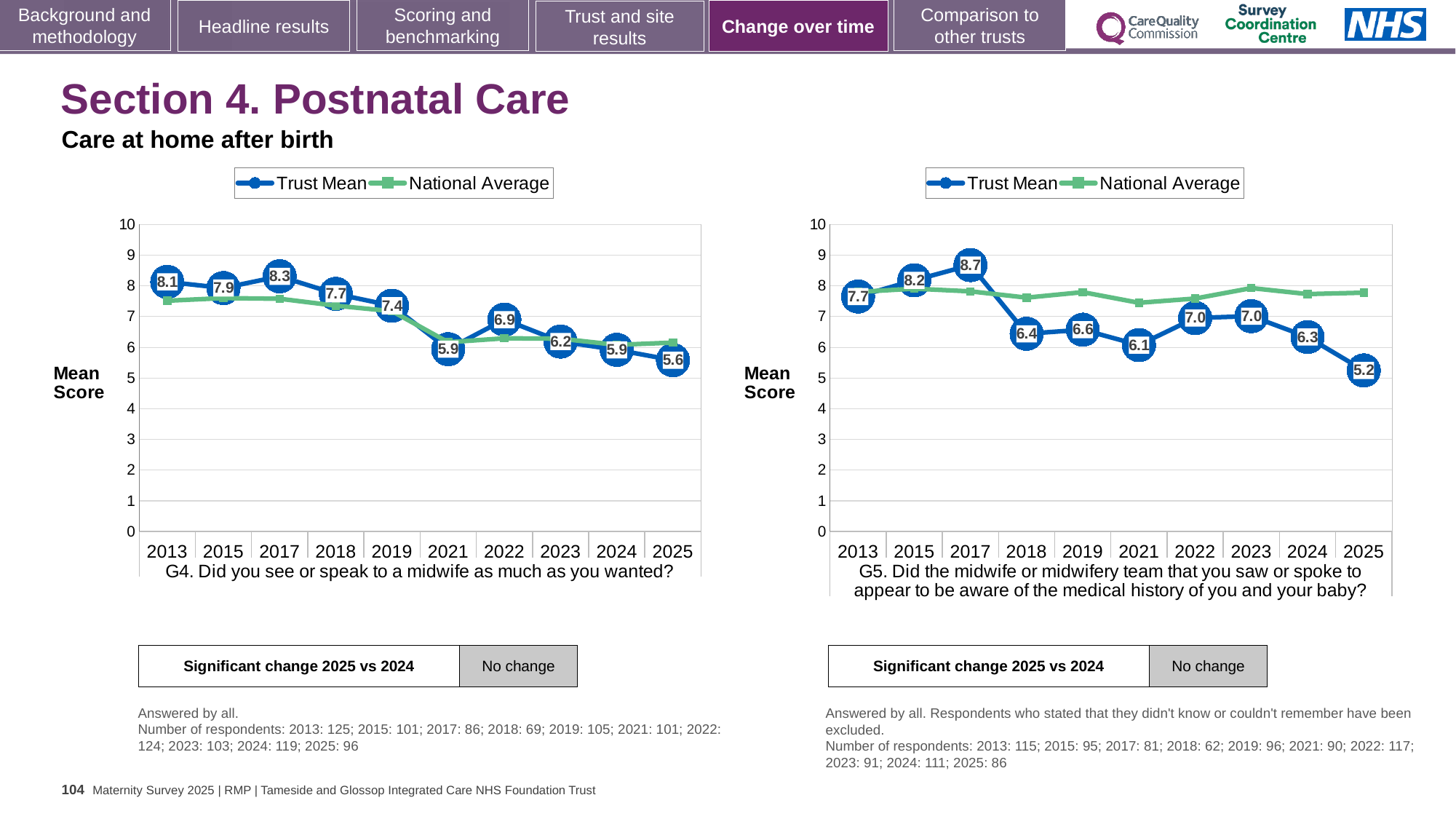
In the G5 chart (right), which year has the lowest Trust Mean score? 2025 In the G5 chart (right), what is the Trust Mean score for 2017? 8.7 In the G5 chart (right), is the National Average value for 2025 greater or less than 7? greater In the G4 chart (left), which year has the highest Trust Mean score? 2017 In the G4 chart (left), how many series does the legend list? 2 In the G4 chart (left), what is the Trust Mean score for 2025? 5.6 In the G4 chart (left), what is the Trust Mean score for 2017? 8.3 In the G5 chart (right), how many years are plotted on the x axis? 10 In the G5 chart (right), does the Trust Mean score rise or fall between 2023 and 2025? fall In the G5 chart (right), is the Trust Mean score for 2018 larger or smaller than the score for 2019? smaller In the G4 chart (left), what is the difference between the Trust Mean scores for 2013 and 2025? 2.5 What kind of chart is the G4 chart on the left? Line chart